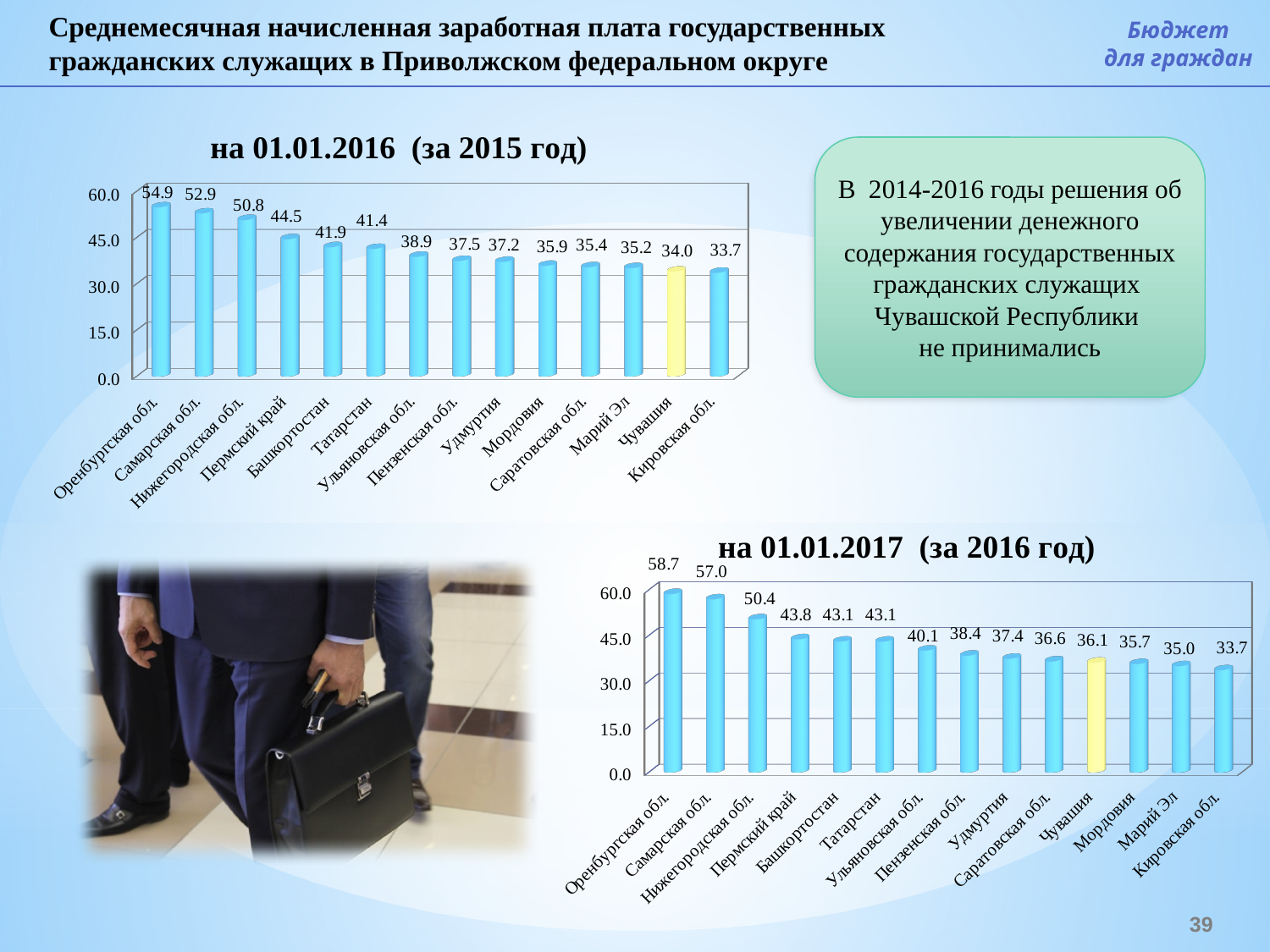
What kind of chart is 'на 01.01.2017 (за 2016 год)'? bar chart In the chart 'на 01.01.2016 (за 2015 год)', which category has the highest value? Оренбургская обл. In the chart 'на 01.01.2016 (за 2015 год)', which bar is coloured yellow instead of blue? Чувашия In the chart 'на 01.01.2017 (за 2016 год)', do the values rise or fall from left to right along the x axis? fall In the chart 'на 01.01.2016 (за 2015 год)', which is larger: the value for Пермский край or the value for Татарстан? Пермский край In the chart 'на 01.01.2017 (за 2016 год)', what is the value for Чувашия? 36.1 In the chart 'на 01.01.2016 (за 2015 год)', what is the difference between the values for Оренбургская обл. and Самарская обл.? 2.0 In the chart 'на 01.01.2017 (за 2016 год)', what is the difference between the values for Оренбургская обл. and Кировская обл.? 25.0 How many categories are shown in the chart 'на 01.01.2016 (за 2015 год)'? 14 In the chart 'на 01.01.2017 (за 2016 год)', which category has the lowest value? Кировская обл. In the chart 'на 01.01.2016 (за 2015 год)', what is the value for Чувашия? 34.0 In the chart 'на 01.01.2017 (за 2016 год)', is the value for Нижегородская обл. greater or less than 45.0? greater